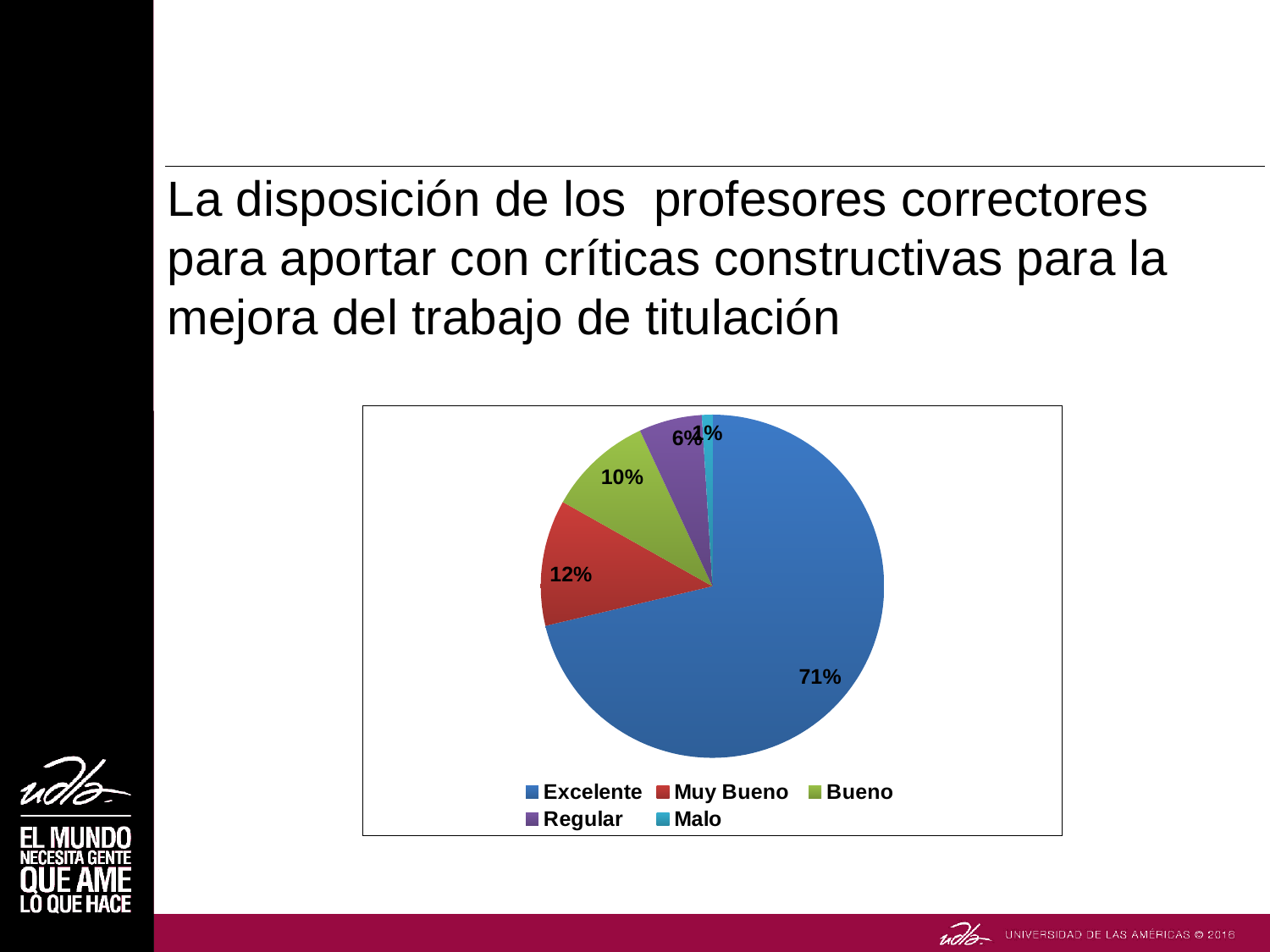
What is the difference in percentage points between the Excelente slice and the Muy Bueno slice? 59 What percentage of the pie is labelled Muy Bueno? 12% How many categories does the legend list? 5 Which category has the largest slice of the pie? Excelente What colour is the Excelente slice of the pie? blue What kind of chart is shown on the slide? pie chart What colour is the Bueno slice of the pie? green What percentage of the pie is labelled Bueno? 10% What percentage of the pie is labelled Regular? 6% Which category has the smallest slice of the pie? Malo Which slice is larger, Muy Bueno or Bueno? Muy Bueno What percentage of the pie is labelled Excelente? 71%